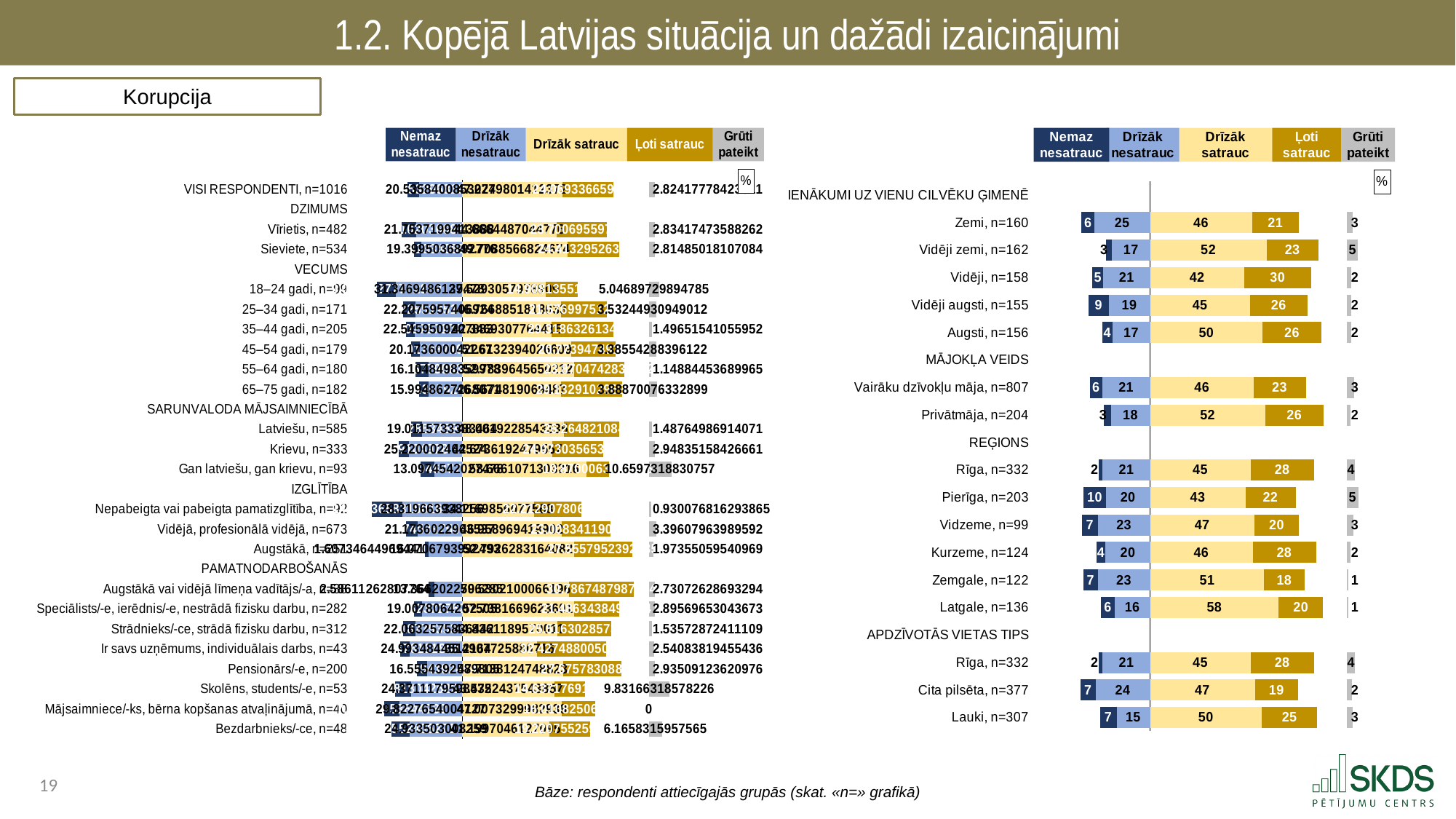
In the right chart, what is the total of the stacked bar for Kurzeme, n=124? 100 In the right chart, what is the 'Drīzāk satrauc' value for Latgale, n=136? 58 In the right chart, what is the 'Ļoti satrauc' value for Vidēji, n=158? 30 In the right chart, which category has the highest 'Drīzāk satrauc' value? Latgale, n=136 In the right chart, which is larger: the 'Ļoti satrauc' value for Rīga, n=332 or for Cita pilsēta, n=377? Rīga, n=332 In the right chart, which region under REĢIONS has the lowest 'Ļoti satrauc' value? Zemgale, n=122 How many category bars are plotted in the right chart? 16 What kind of chart is the right chart? Stacked bar chart How many series does the legend of the right chart list? 5 In the right chart, what is the 'Nemaz nesatrauc' value for Pierīga, n=203? 10 In the left chart, which legend entry is shown in the darkest blue colour? Nemaz nesatrauc In the right chart, what is the difference between the 'Drīzāk satrauc' values for Privātmāja, n=204 and Vairāku dzīvokļu māja, n=807? 6